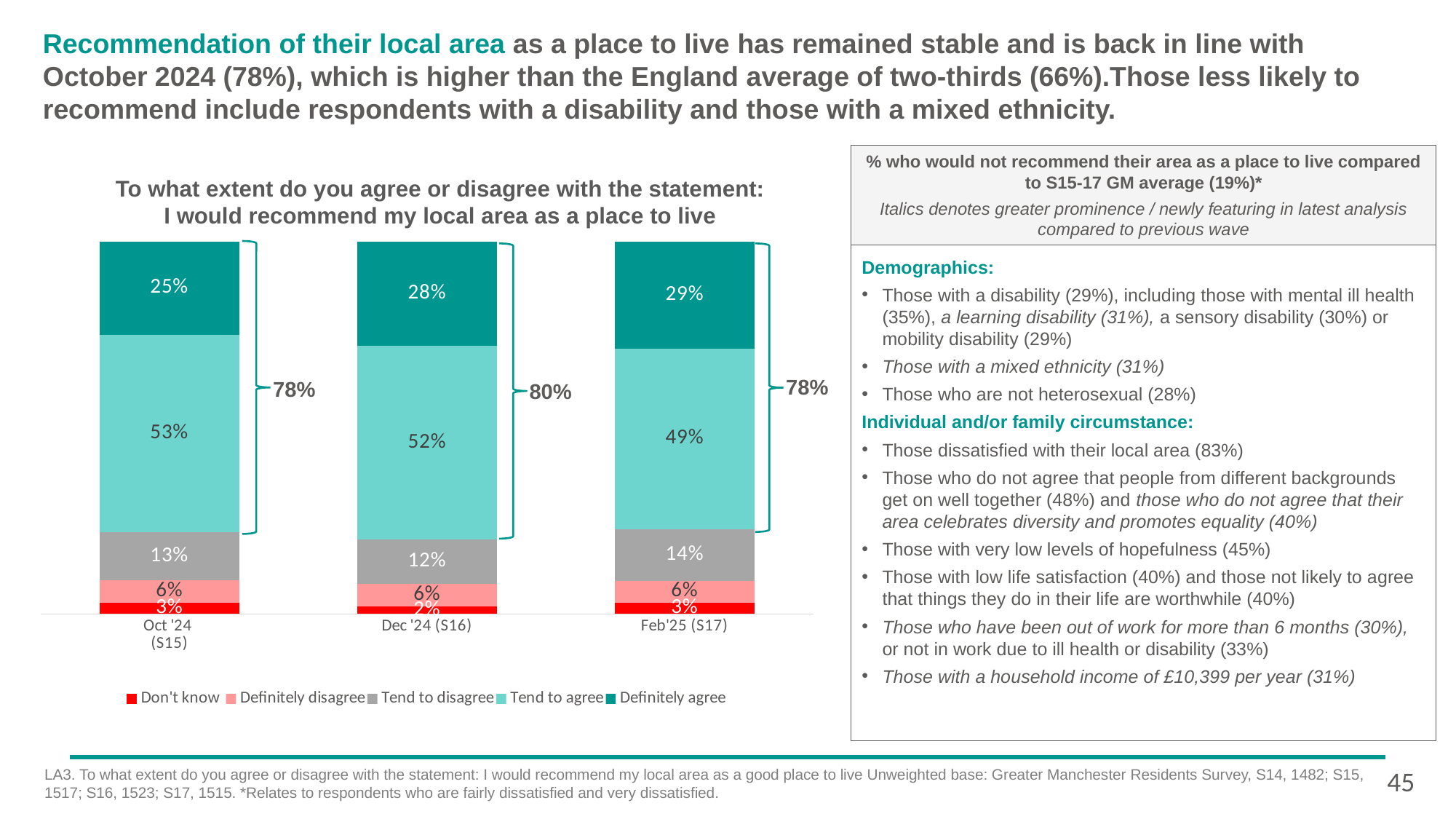
What type of chart is shown on the slide? Stacked bar chart What is the difference between the 'Definitely agree' values for Feb'25 (S17) and Oct '24 (S15)? 4 percentage points What is the 'Definitely agree' value for Feb'25 (S17)? 29% What is the 'Tend to agree' value for Oct '24 (S15)? 53% What is the 'Don't know' value for Dec '24 (S16)? 2% How many survey waves (categories) are shown on the x axis of the chart? 3 What is the combined 'Tend to agree' plus 'Definitely agree' total shown by the bracket for Dec '24 (S16)? 80% Which is larger: the 'Tend to disagree' value for Feb'25 (S17) or for Dec '24 (S16)? Feb'25 (S17) Which wave has the lowest 'Tend to agree' value? Feb'25 (S17) What is the 'Tend to disagree' value for Dec '24 (S16)? 12% How many series does the chart legend list? 5 Which wave has the highest 'Definitely agree' value? Feb'25 (S17)